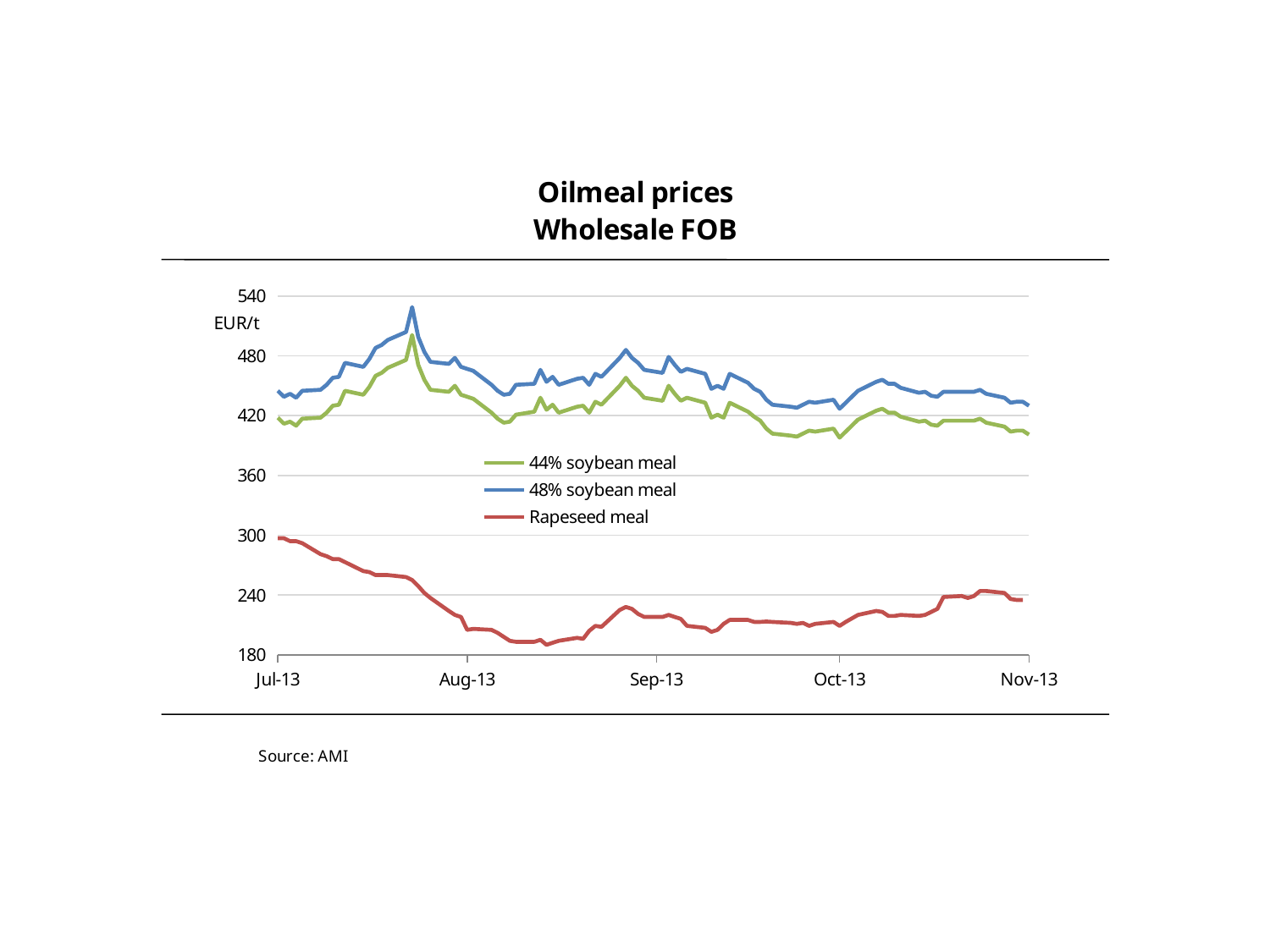
Which is higher at Nov-13, 48% soybean meal or Rapeseed meal? 48% soybean meal What kind of chart is shown on the slide? line chart What is the title of the chart? Oilmeal prices Wholesale FOB Is the value for 44% soybean meal at Nov-13 greater or less than 420? less How many series does the legend list? 3 What unit is shown on the y axis of the chart? EUR/t Does the Rapeseed meal price rise or fall between Jul-13 and Aug-13? fall Which series has the highest prices throughout the period? 48% soybean meal Is the value for Rapeseed meal at Aug-13 greater or less than 240? less Does the 48% soybean meal price rise or fall overall between Sep-13 and Nov-13? fall Is the value for 48% soybean meal at Jul-13 greater or less than 420? greater Which series has the lowest prices throughout the period? Rapeseed meal